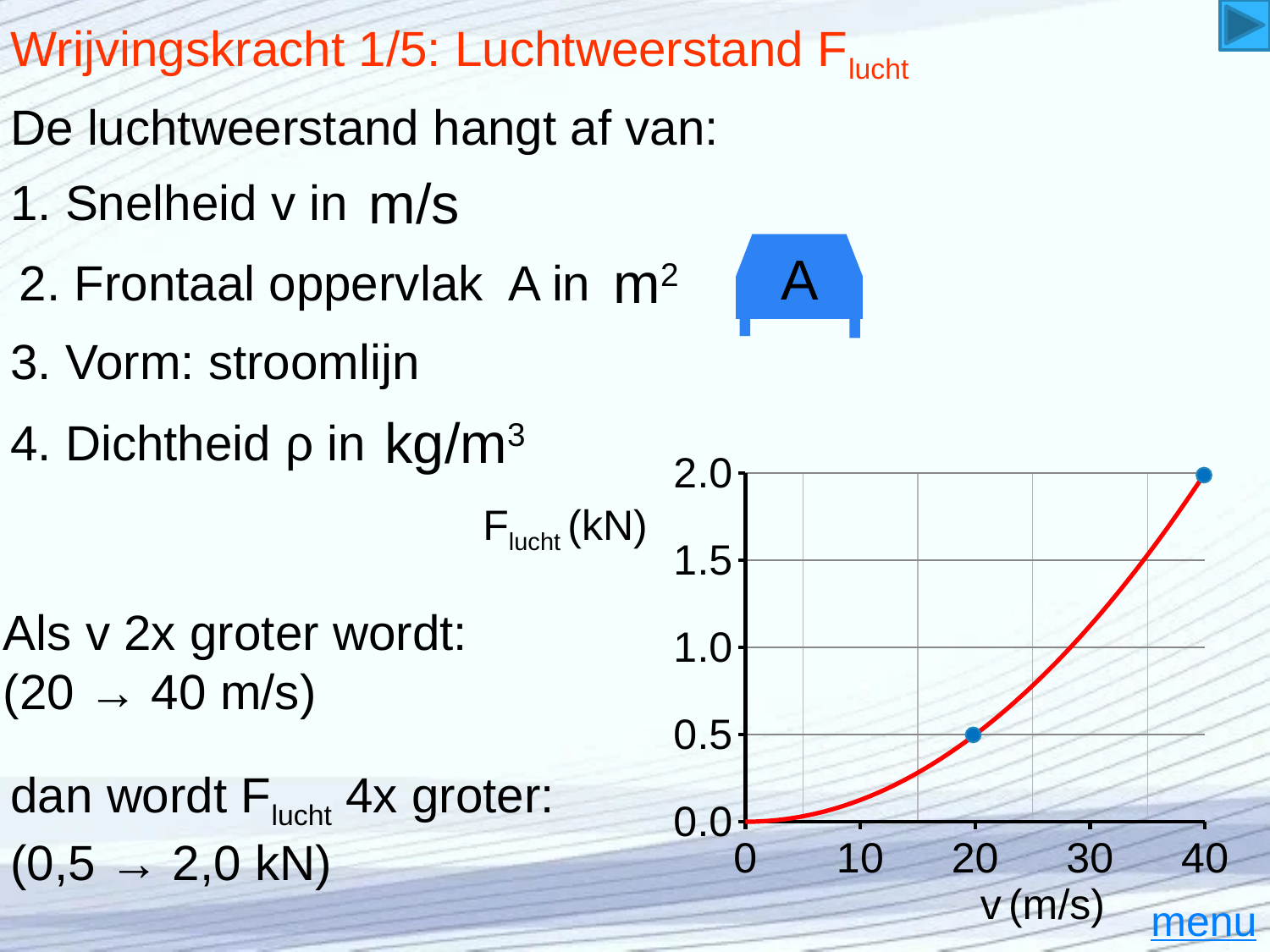
What is the label of the horizontal axis? v (m/s) What is the value of F_lucht at v = 20 m/s? 0.5 kN Which of the two marked points has the higher F_lucht value, the one at 20 m/s or the one at 40 m/s? 40 m/s What is the difference between F_lucht at 40 m/s and F_lucht at 20 m/s? 1.5 kN Is the value of F_lucht at v = 30 m/s greater or less than 1.5? less Is the value of F_lucht at v = 10 m/s greater or less than 0.5? less How many data points are marked with dots on the curve? 2 What is the label of the vertical axis? F_lucht (kN) Does F_lucht rise or fall as v increases along the x axis? rise At which marked speed is F_lucht lowest? 20 m/s What kind of chart is shown on the slide? line chart What is the value of F_lucht at v = 40 m/s? 2.0 kN